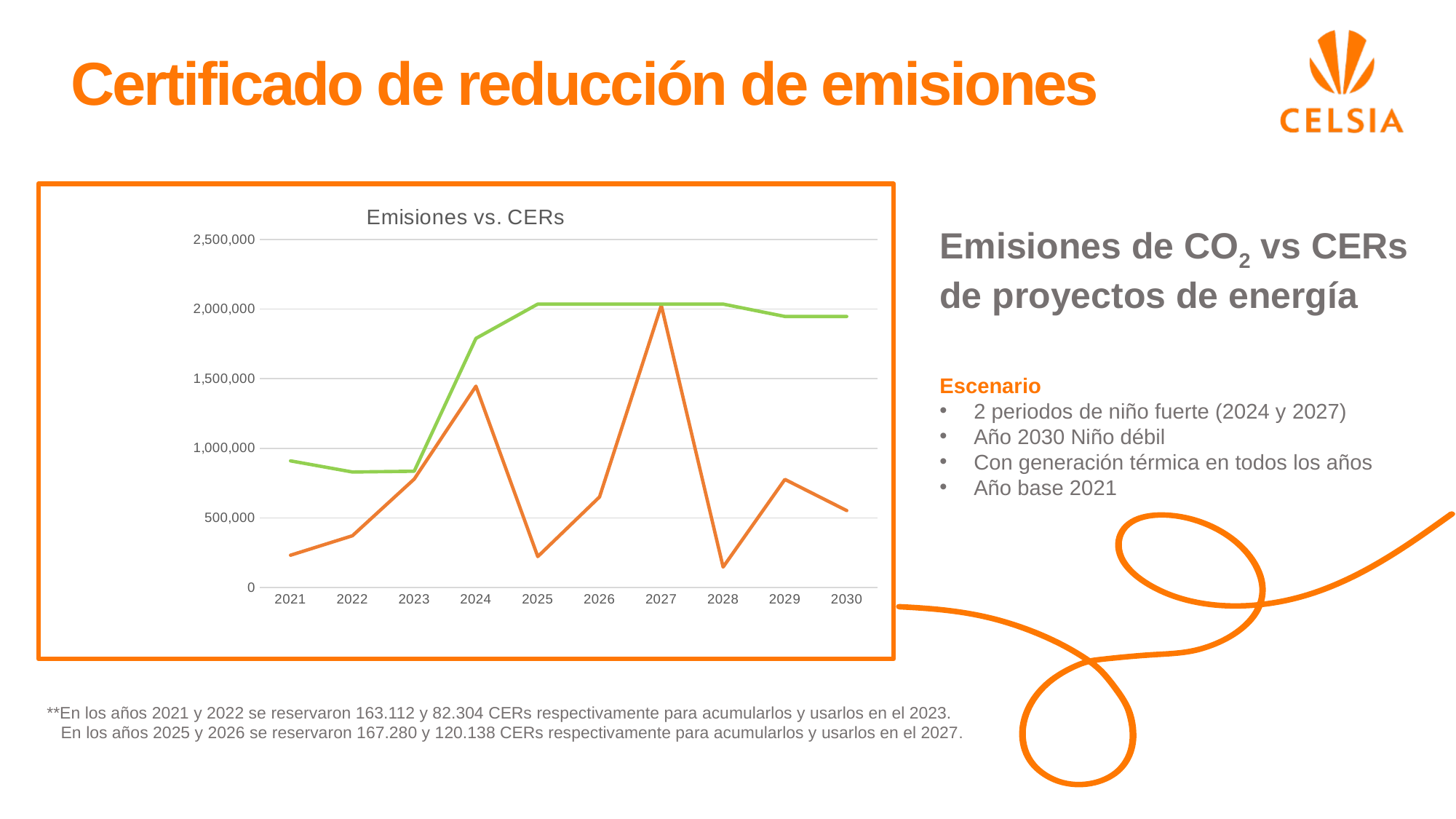
Is the value of the orange line in 2028 greater or less than 500,000? less In which year does the orange line reach its highest value? 2027 How many lines are plotted in the chart? 2 How many years are shown along the x axis of the chart? 10 What kind of chart is shown on the slide? line chart In which year does the orange line reach its lowest value? 2028 Is the value of the orange line in 2024 greater or less than 1,000,000? greater In 2024, which line has the higher value, the green line or the orange line? the green line Is the value of the green line in 2024 greater or less than 1,500,000? greater Does the green line rise or fall from 2023 to 2025? rise What is the title of the chart? Emisiones vs. CERs